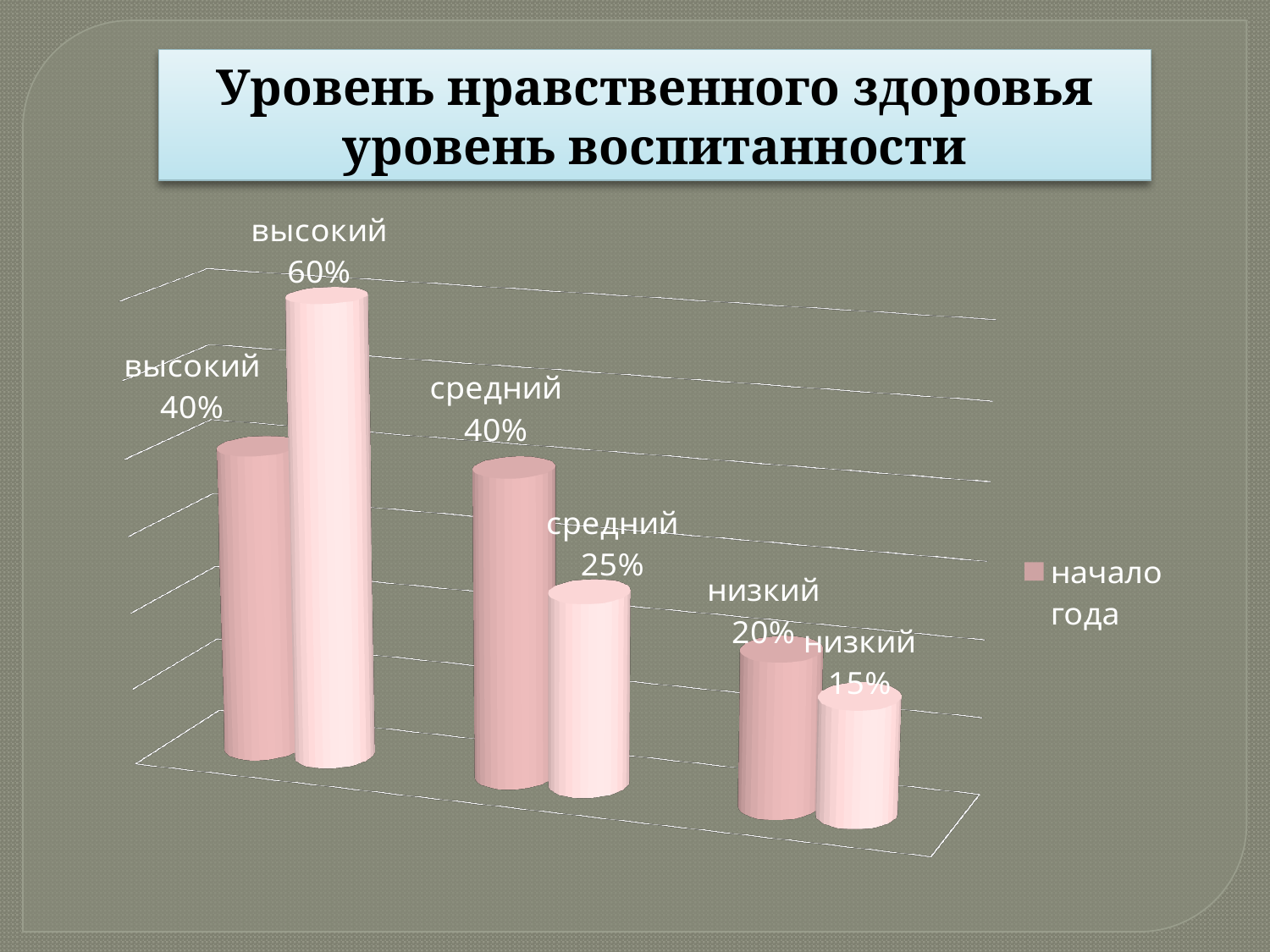
What is the value of the lighter bar for the 'средний' category? 25% What is the value of the lighter bar for the 'низкий' category? 15% What is the value of the lighter bar for the 'высокий' category? 60% What is the value for the 'высокий' category in the 'начало года' series? 40% Which category has the highest value among the lighter bars? высокий What is the value for the 'средний' category in the 'начало года' series? 40% Which category has the lowest value in the 'начало года' series? низкий What is the value for the 'низкий' category in the 'начало года' series? 20% What kind of chart is shown on the slide? bar chart How many categories are shown on the chart? 3 What is the difference between the lighter bar and the 'начало года' bar for the 'высокий' category? 20% Which is larger for the 'средний' category: the 'начало года' bar or the lighter bar? начало года